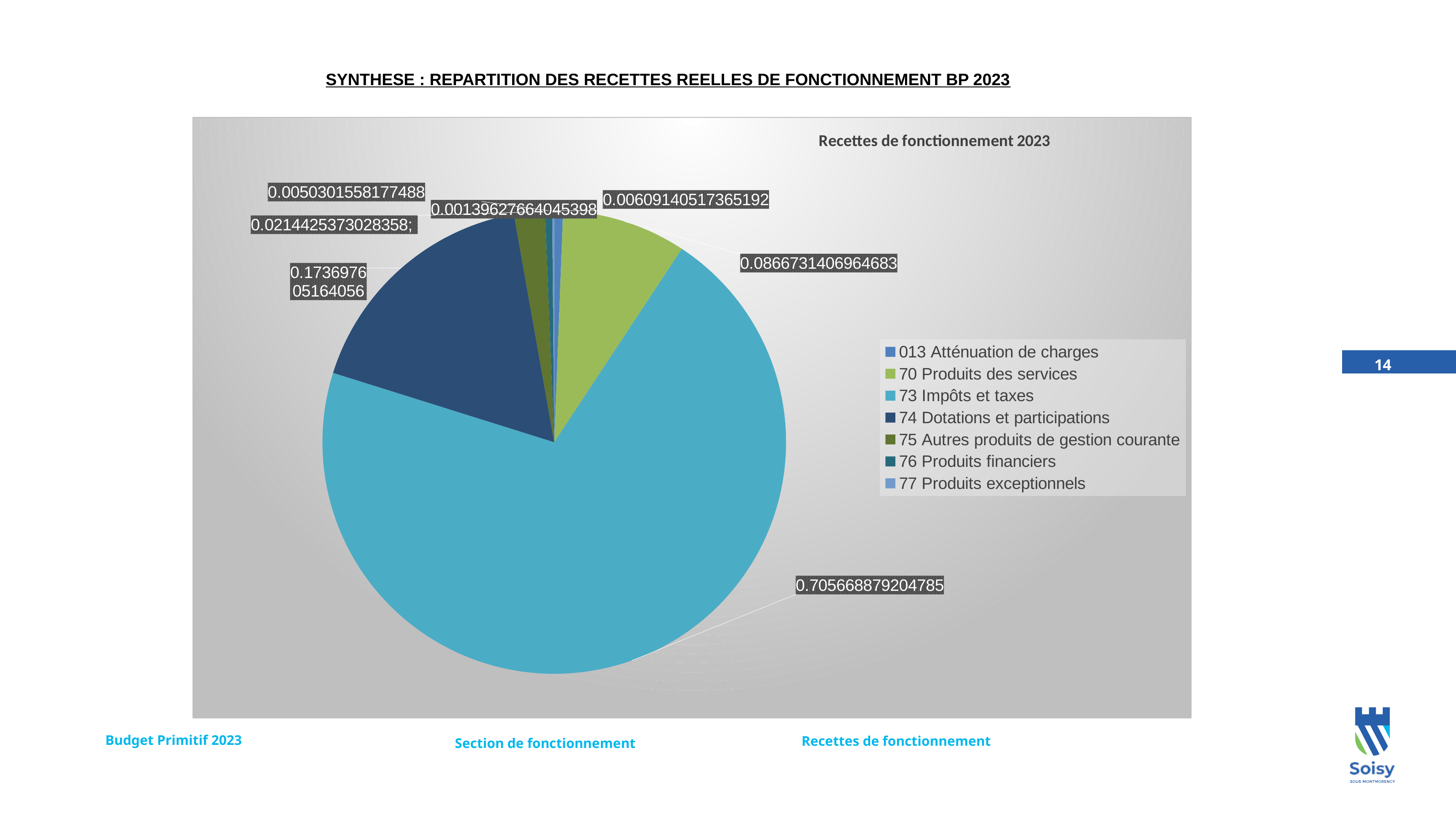
Which is larger, 70 Produits des services or 75 Autres produits de gestion courante? 70 Produits des services What is the value shown for 70 Produits des services? 0.0866731406964683 What is the difference between the values for 73 Impôts et taxes and 74 Dotations et participations? 0.531971274040729 What is the value shown for 74 Dotations et participations? 0.173697605164056 How many categories does the pie chart show? 7 What is the value shown for 73 Impôts et taxes? 0.705668879204785 Which category has the largest slice of the pie? 73 Impôts et taxes What is the value shown for 75 Autres produits de gestion courante? 0.0214425373028358 What kind of chart is shown on the slide? pie chart What is the first entry listed in the legend? 013 Atténuation de charges Which is larger, 74 Dotations et participations or 70 Produits des services? 74 Dotations et participations What is the title of the pie chart? Recettes de fonctionnement 2023